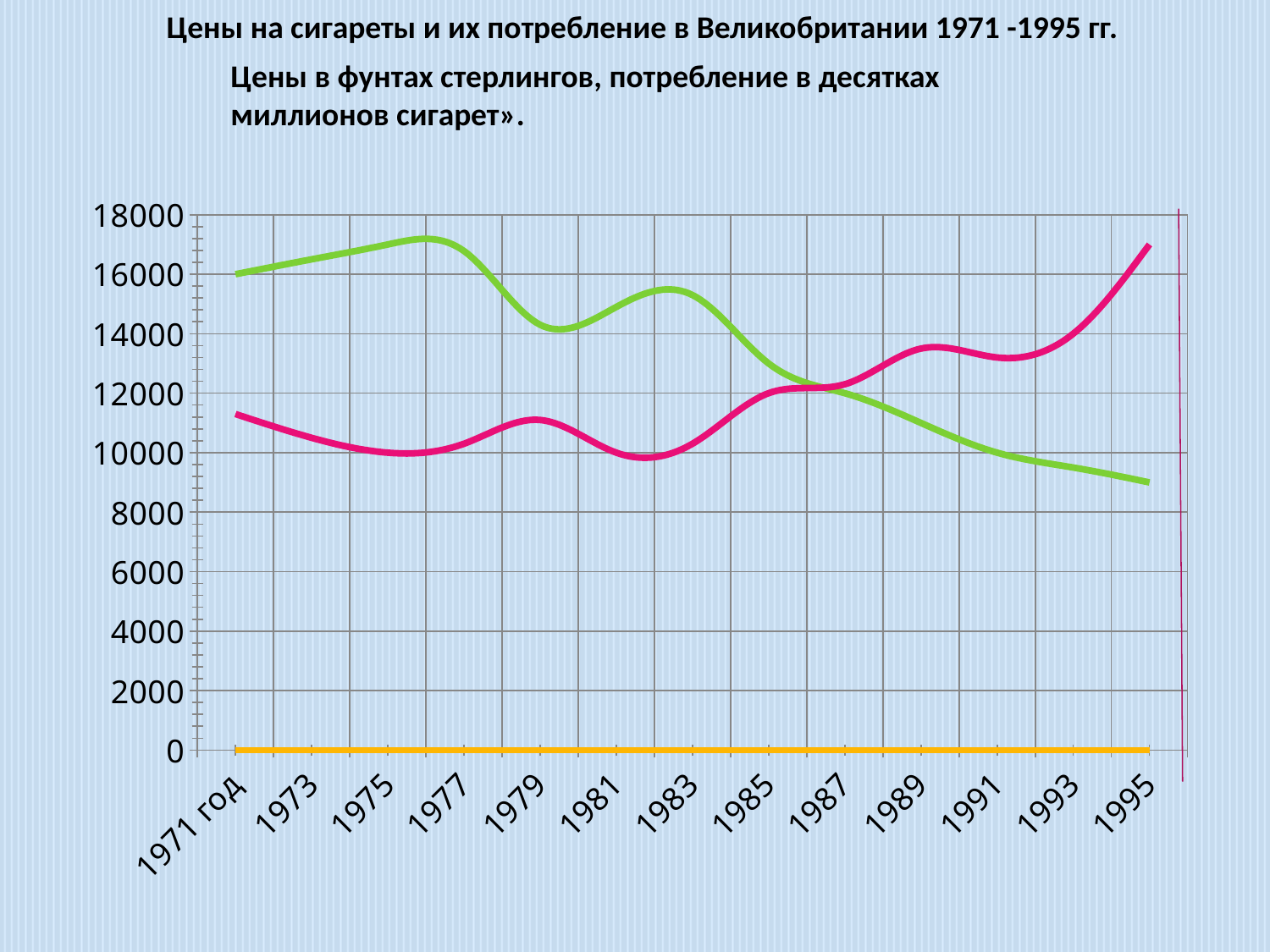
Is the value of the pink line in 1995 greater or less than 16000? greater Overall, does the pink line rise or fall from 1971 to 1995? rise Is the value of the green line in 1995 greater or less than 10000? less Is the value of the pink line in 1989 greater or less than 12000? greater What kind of chart is shown on the slide? line chart What is the highest value shown on the y axis? 18000 Overall, does the green line rise or fall from 1971 to 1995? fall In 1971, which line is higher, the green line or the pink line? the green line In 1995, which line is higher, the green line or the pink line? the pink line How many year labels are shown along the x axis? 13